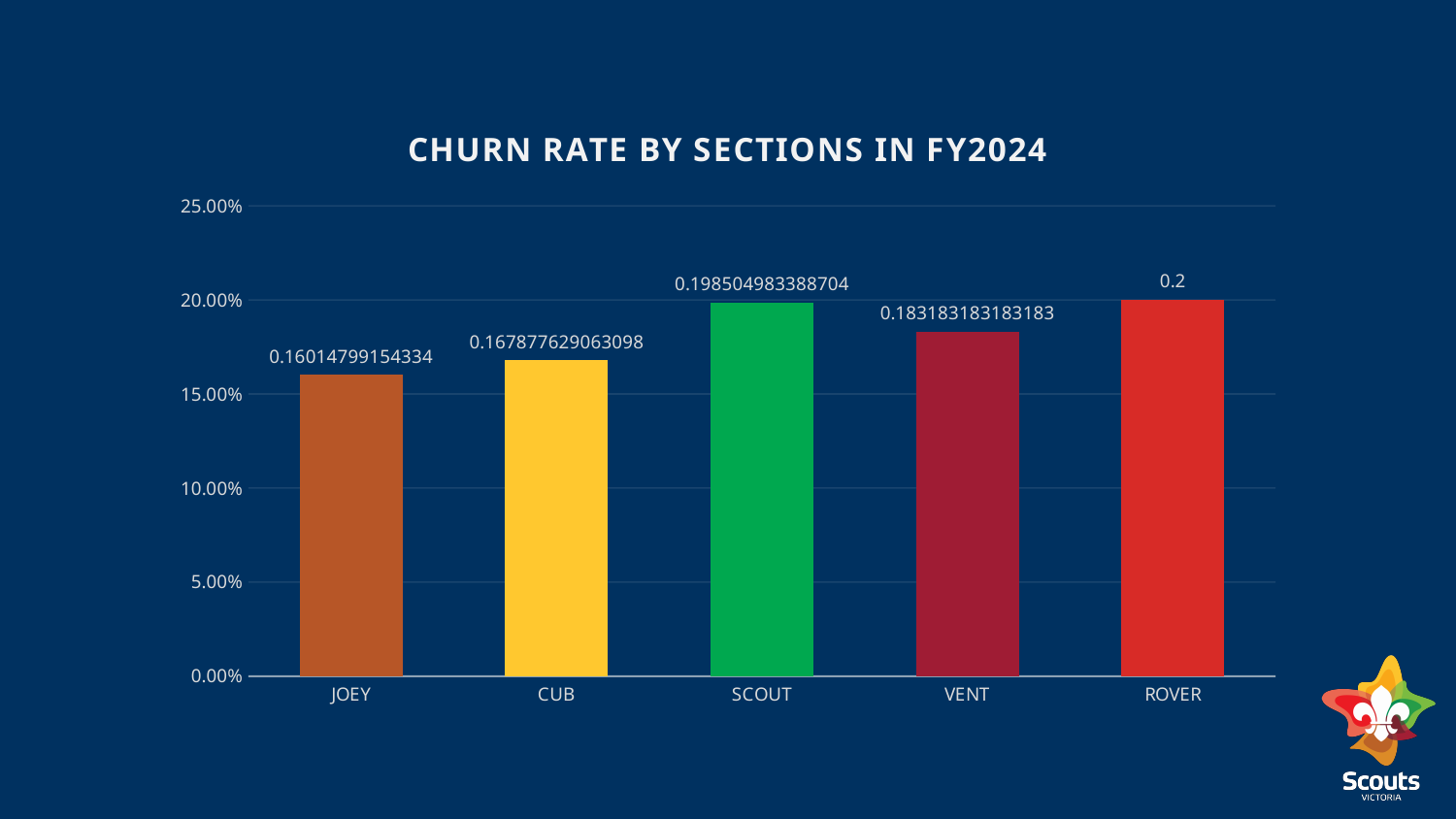
What is the churn rate value shown for ROVER? 0.2 Which section has the highest churn rate? ROVER Is the churn rate for JOEY greater or less than 15.00%? greater What kind of chart is shown on the slide? Bar chart What is the churn rate value shown for VENT? 0.183183183183183 What is the churn rate value shown for SCOUT? 0.198504983388704 Which has a higher churn rate, CUB or VENT? VENT How many sections are shown on the chart? 5 Is the churn rate for CUB greater or less than 20.00%? less Which section has the lowest churn rate? JOEY What is the title of the chart? CHURN RATE BY SECTIONS IN FY2024 What is the churn rate value shown for JOEY? 0.16014799154334